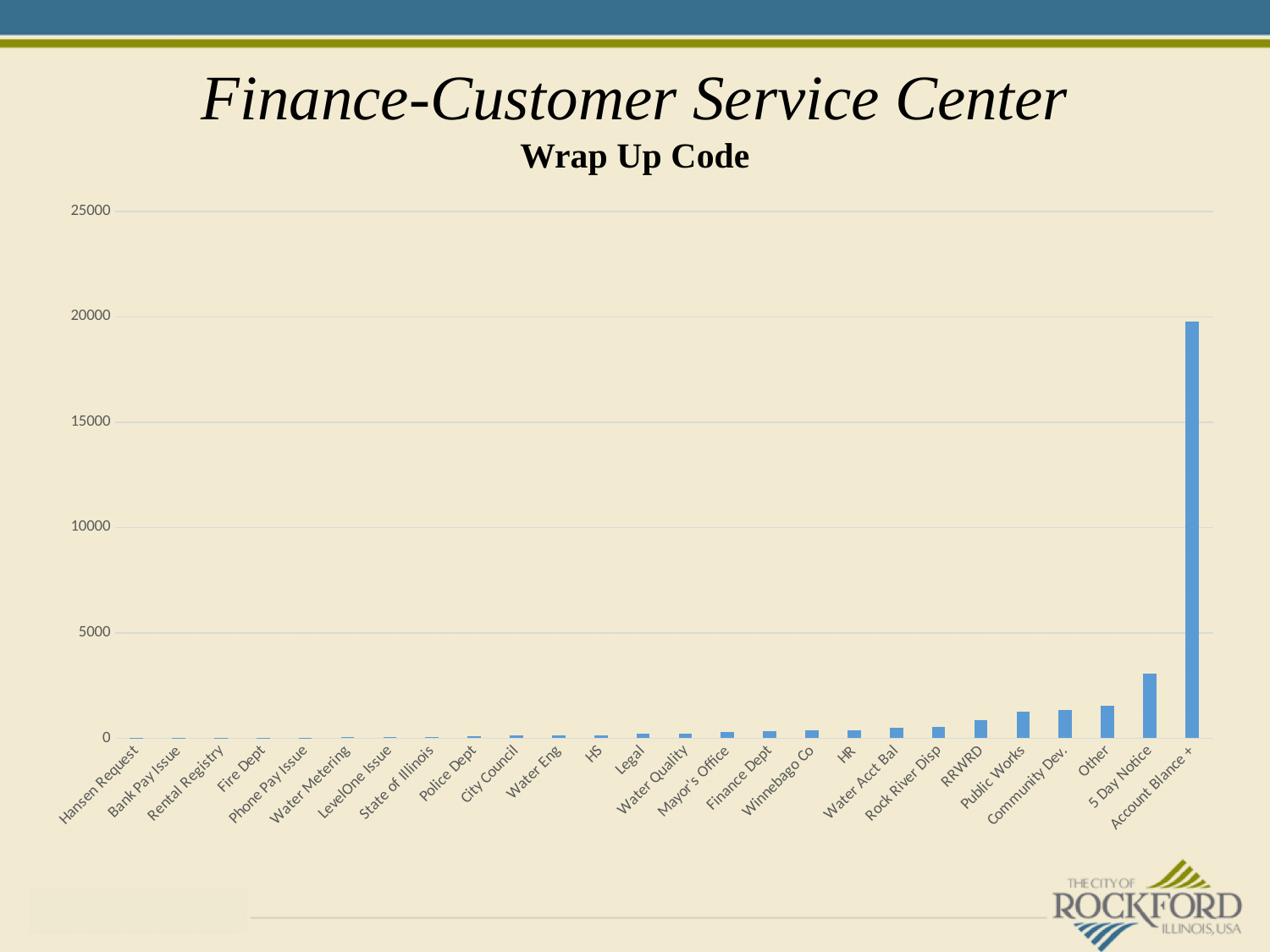
Is the value for Account Blance + greater or less than 15000? greater Which is larger, the value for 5 Day Notice or the value for Other? 5 Day Notice How many categories are plotted along the x axis of the chart? 26 What is the title of the chart? Wrap Up Code Which category has the highest value in the chart? Account Blance + Is the value for Other greater or less than 5000? less Do the bar values generally rise or fall moving from left to right along the x axis? rise Is the value for 5 Day Notice greater or less than 5000? less Which is larger, the value for Account Blance + or the value for 5 Day Notice? Account Blance + What kind of chart is shown on the slide? bar chart Which is larger, the value for Public Works or the value for Hansen Request? Public Works